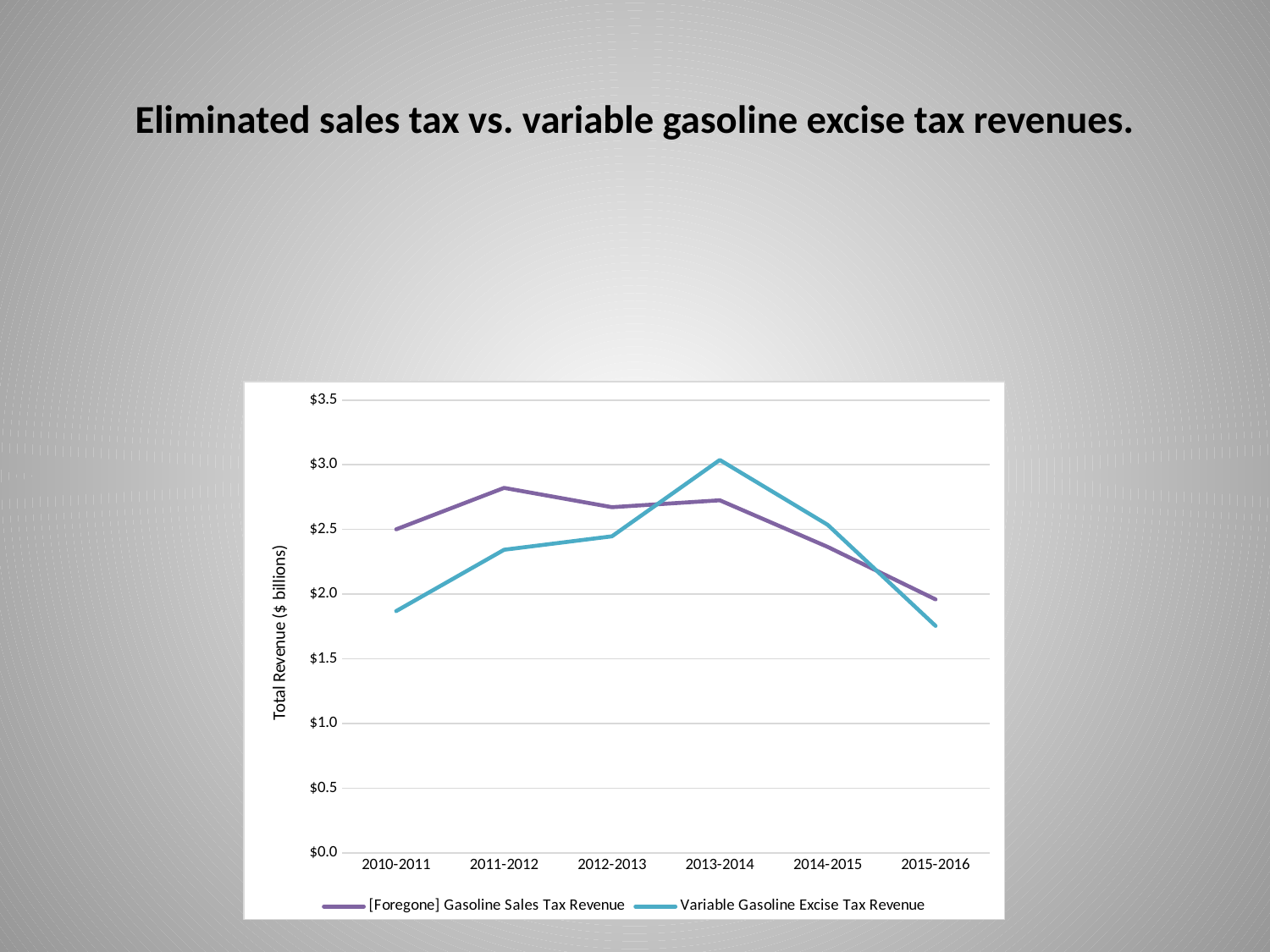
Which series has the higher value in 2013-2014? Variable Gasoline Excise Tax Revenue Is the value for Variable Gasoline Excise Tax Revenue in 2010-2011 greater or less than $2.0? less How many series does the legend list? 2 Does Variable Gasoline Excise Tax Revenue rise or fall from 2010-2011 to 2013-2014? rise In which fiscal year is [Foregone] Gasoline Sales Tax Revenue lowest? 2015-2016 Is the value for [Foregone] Gasoline Sales Tax Revenue in 2011-2012 greater or less than $2.5? greater What kind of chart is shown on the slide? line chart In which fiscal year is [Foregone] Gasoline Sales Tax Revenue highest? 2011-2012 Which series has the higher value in 2010-2011? [Foregone] Gasoline Sales Tax Revenue In which fiscal year is Variable Gasoline Excise Tax Revenue highest? 2013-2014 What is the label on the y axis? Total Revenue ($ billions) How many fiscal years are plotted along the x axis? 6